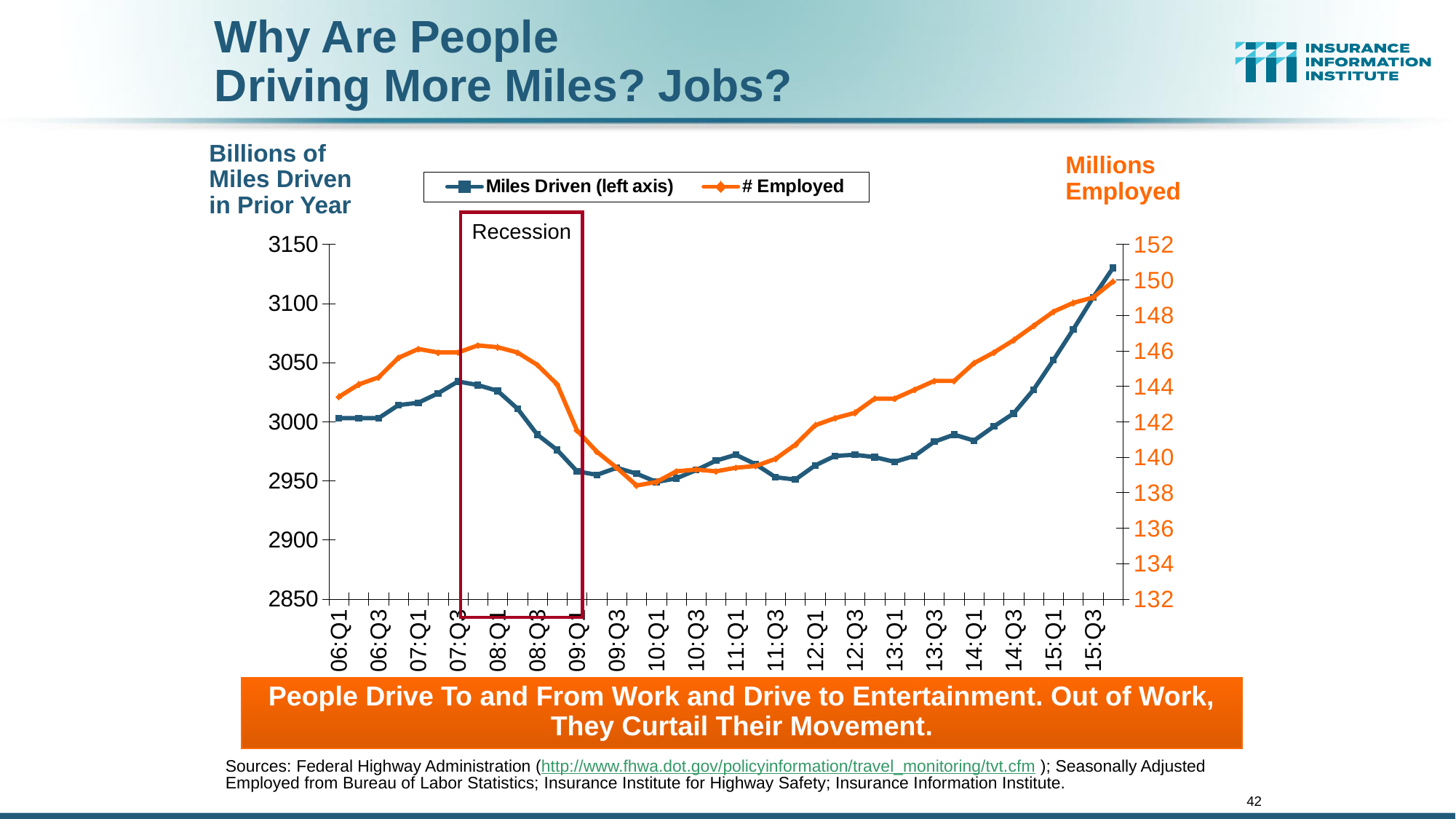
Does the Miles Driven series rise or fall between 07:Q3 and 09:Q1? fall What does the red rectangle on the chart mark? Recession How many series does the legend list? 2 What kind of chart is shown on the slide? line chart Does the # Employed series rise or fall between 12:Q1 and 15:Q3? rise Is the # Employed value at 09:Q3 greater or less than 140? less Which series is plotted against the left axis according to the legend? Miles Driven (left axis) Is the Miles Driven value at 09:Q1 greater or less than 3000? less Is the # Employed value at 15:Q3 greater or less than 148? greater